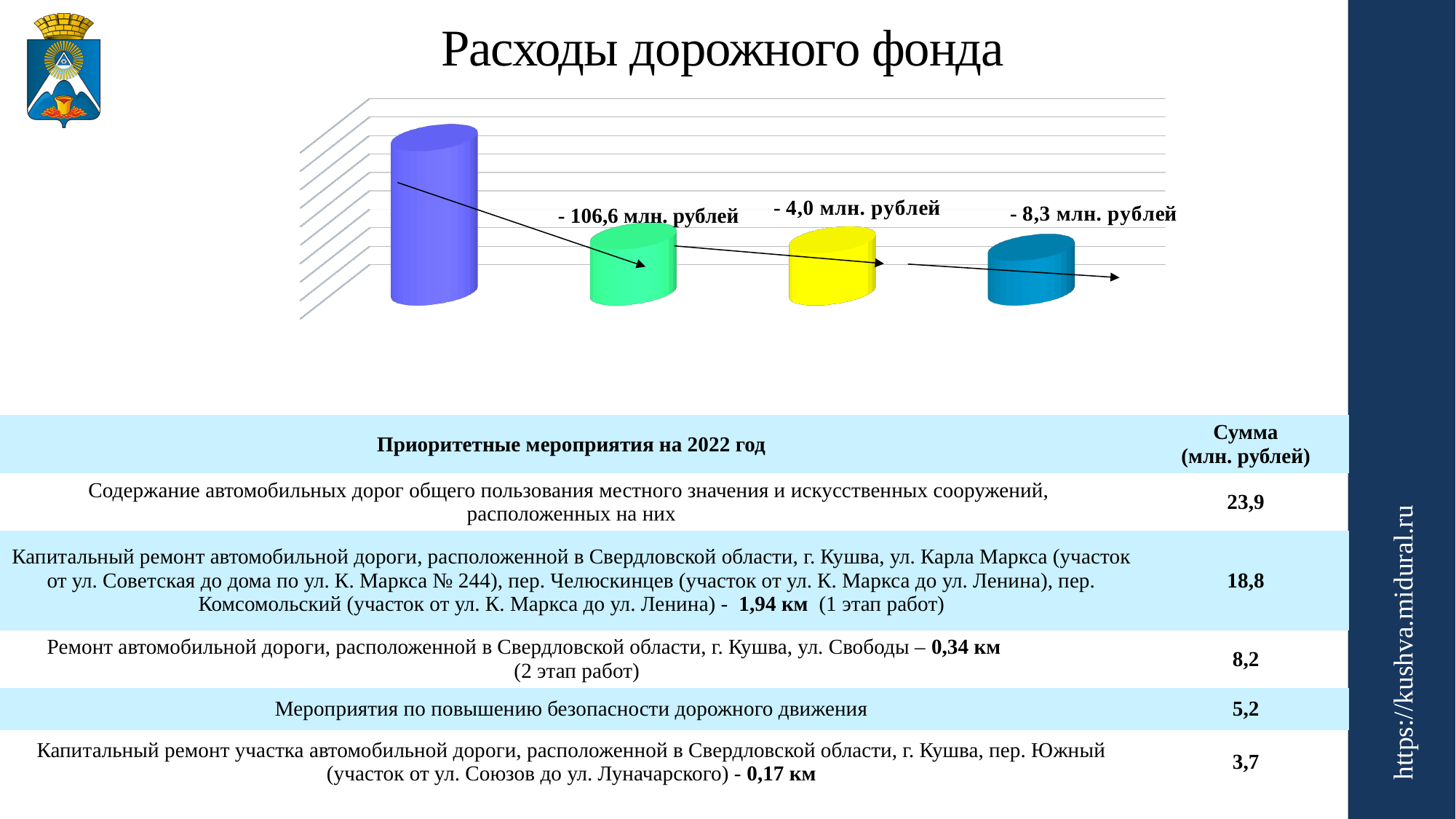
Which is larger, the green bar or the blue bar? the green bar What is the title of the chart on the slide? Расходы дорожного фонда Which bar is the shortest in the chart? the last (blue) bar What label is printed above the blue (fourth) bar? - 8,3 млн. рублей How many bars does the chart contain? 4 What kind of chart is shown on the slide? bar chart What label is printed next to the green (second) bar? - 106,6 млн. рублей Which is larger, the purple bar or the green bar? the purple bar What label is printed above the yellow (third) bar? - 4,0 млн. рублей Do the bar values rise or fall from left to right across the chart? fall What colour is the tallest bar in the chart? purple Which bar is the tallest in the chart? the first (purple) bar